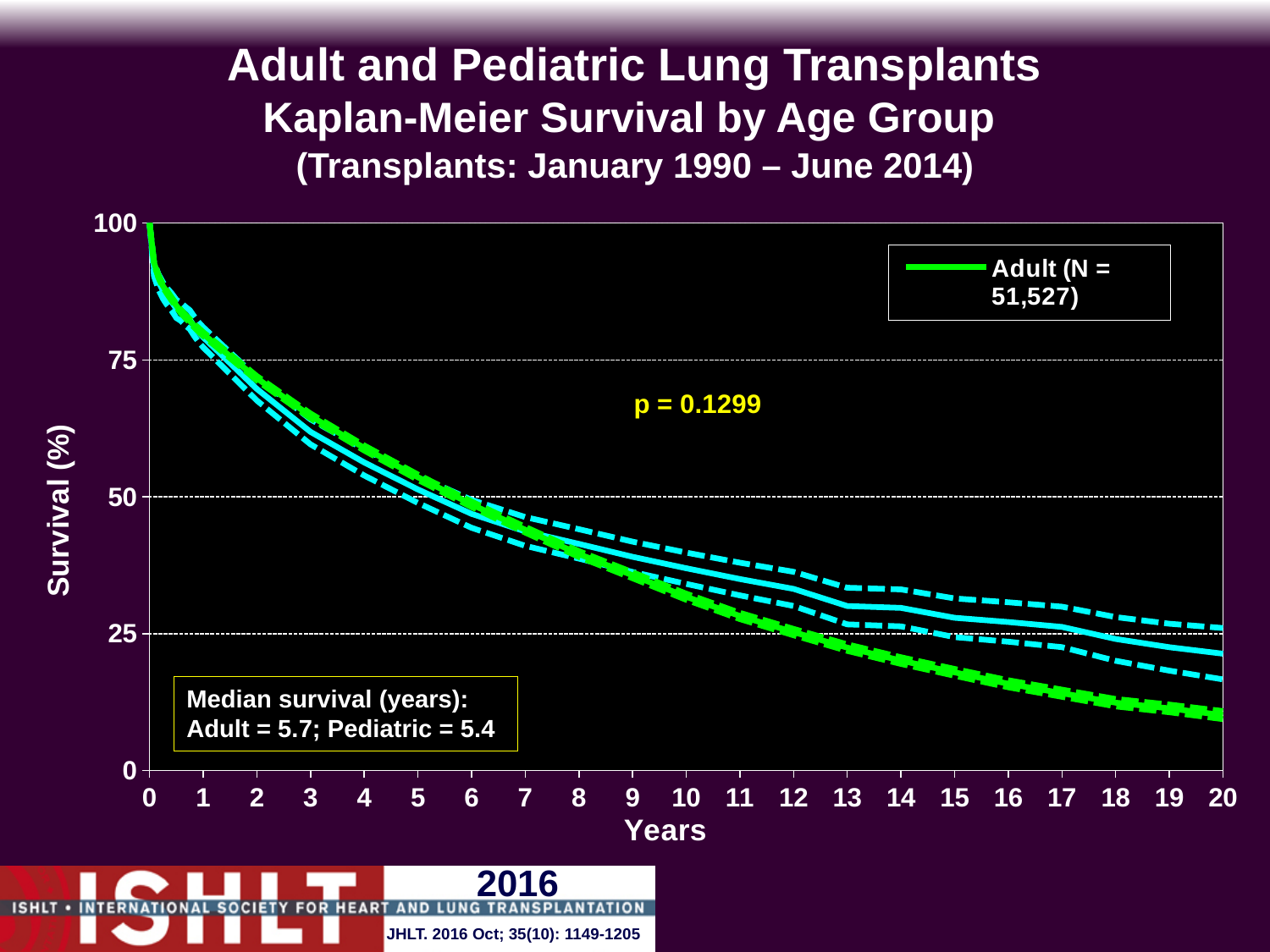
Is the Adult survival at 5 years greater or less than 50? greater What is the median survival in years for the Pediatric group? 5.4 What is the difference in median survival (years) between the Adult and Pediatric groups? 0.3 What kind of chart is shown on the slide? line chart What is the median survival in years for the Adult group? 5.7 What is the N for the Adult group shown in the legend? 51,527 Which group has the longer median survival, Adult or Pediatric? Adult Does survival rise or fall as years increase? fall What p-value is shown on the chart? p = 0.1299 What is the label of the y axis? Survival (%) How many series does the legend list? 1 Is the Adult survival at 20 years greater or less than 25? less